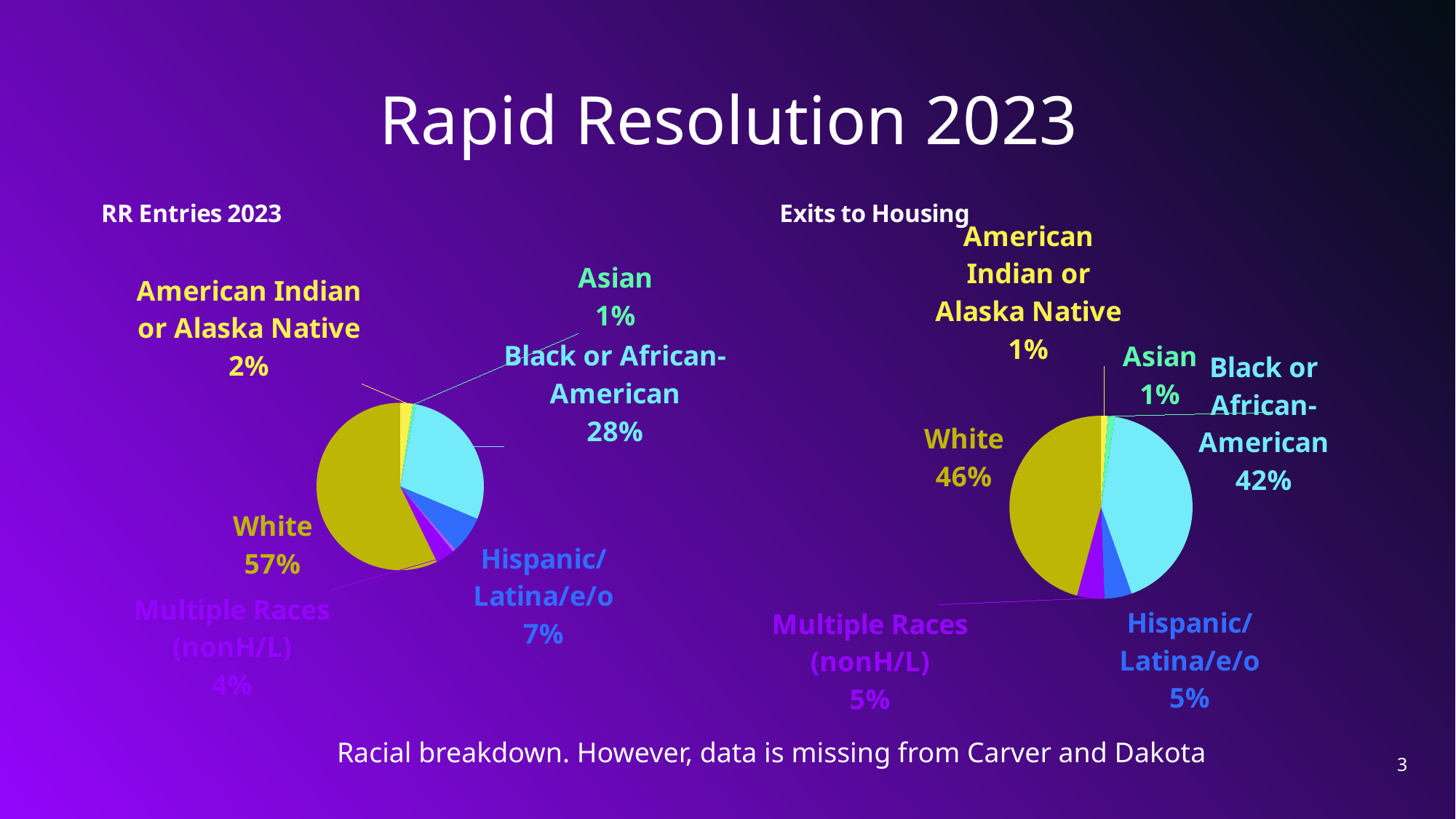
What kind of chart is used for Exits to Housing? Pie chart In the RR Entries 2023 chart, what is the share for Hispanic/Latina/e/o? 7% In the RR Entries 2023 chart, what share of the pie is White? 57% In the RR Entries 2023 chart, how many categories are labelled? 6 In the RR Entries 2023 chart, which is larger, the share for Hispanic/Latina/e/o or the share for Multiple Races (nonH/L)? Hispanic/Latina/e/o In the Exits to Housing chart, what is the share for Multiple Races (nonH/L)? 5% In the Exits to Housing chart, what is the difference between the White share and the Black or African-American share? 4% What is the difference between the White share in RR Entries 2023 and the White share in Exits to Housing? 11% In the Exits to Housing chart, what share of the pie is White? 46% In the RR Entries 2023 chart, what share of the pie is Black or African-American? 28% In the RR Entries 2023 chart, which category has the largest share? White